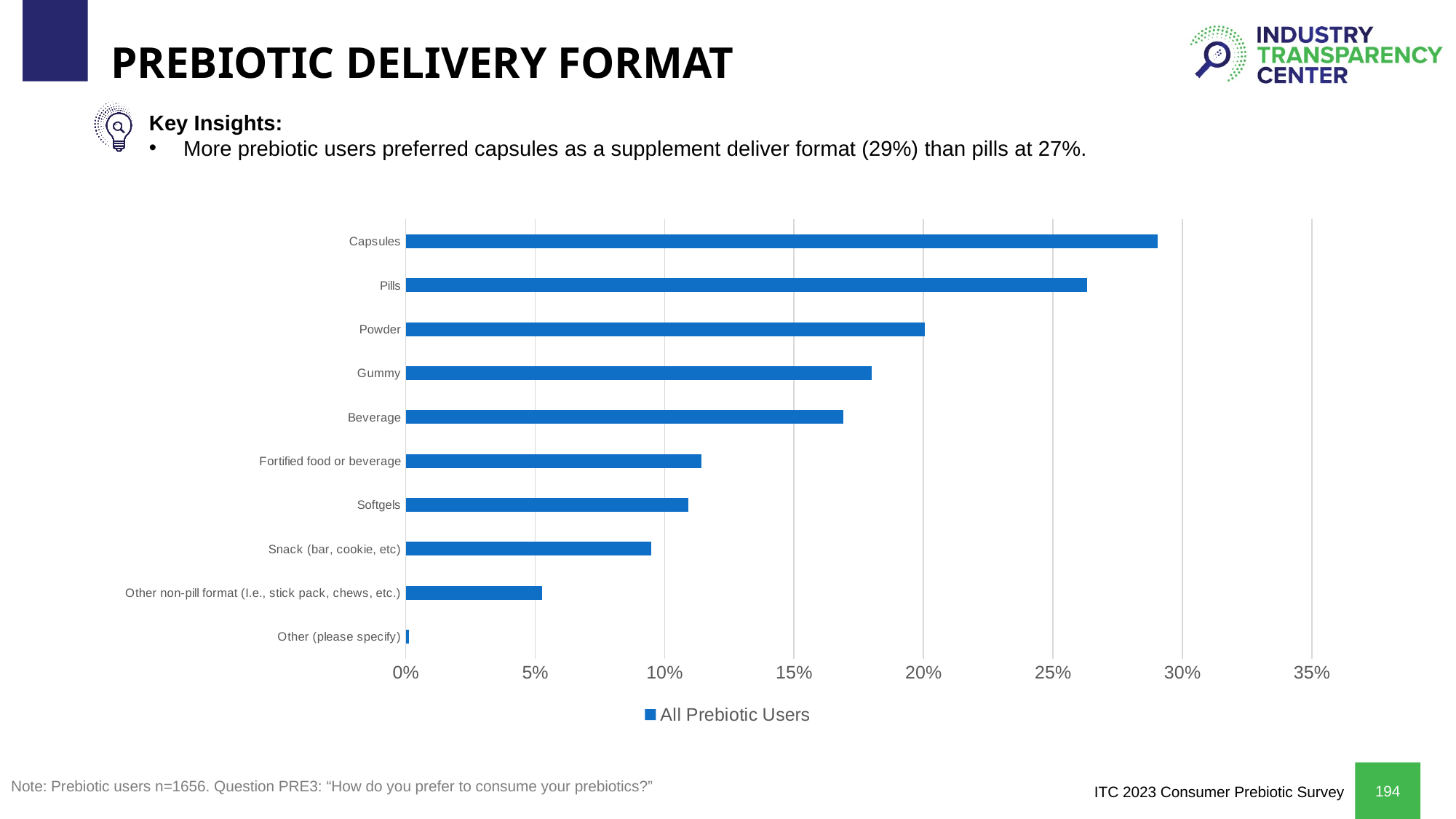
What type of chart is shown on the slide? bar chart Is the value for Snack (bar, cookie, etc) greater or less than 10%? less How many delivery format categories are shown in the chart? 10 Is the value for Fortified food or beverage greater or less than 10%? greater What is the name of the series shown in the legend? All Prebiotic Users How many series does the legend list? 1 Which delivery format has the highest value? Capsules What percentage of prebiotic users preferred pills? 27% Which delivery format has the lowest value? Other (please specify) Is the value for Gummy greater or less than 15%? greater What percentage of prebiotic users preferred capsules? 29% Which has a larger value, Powder or Gummy? Powder